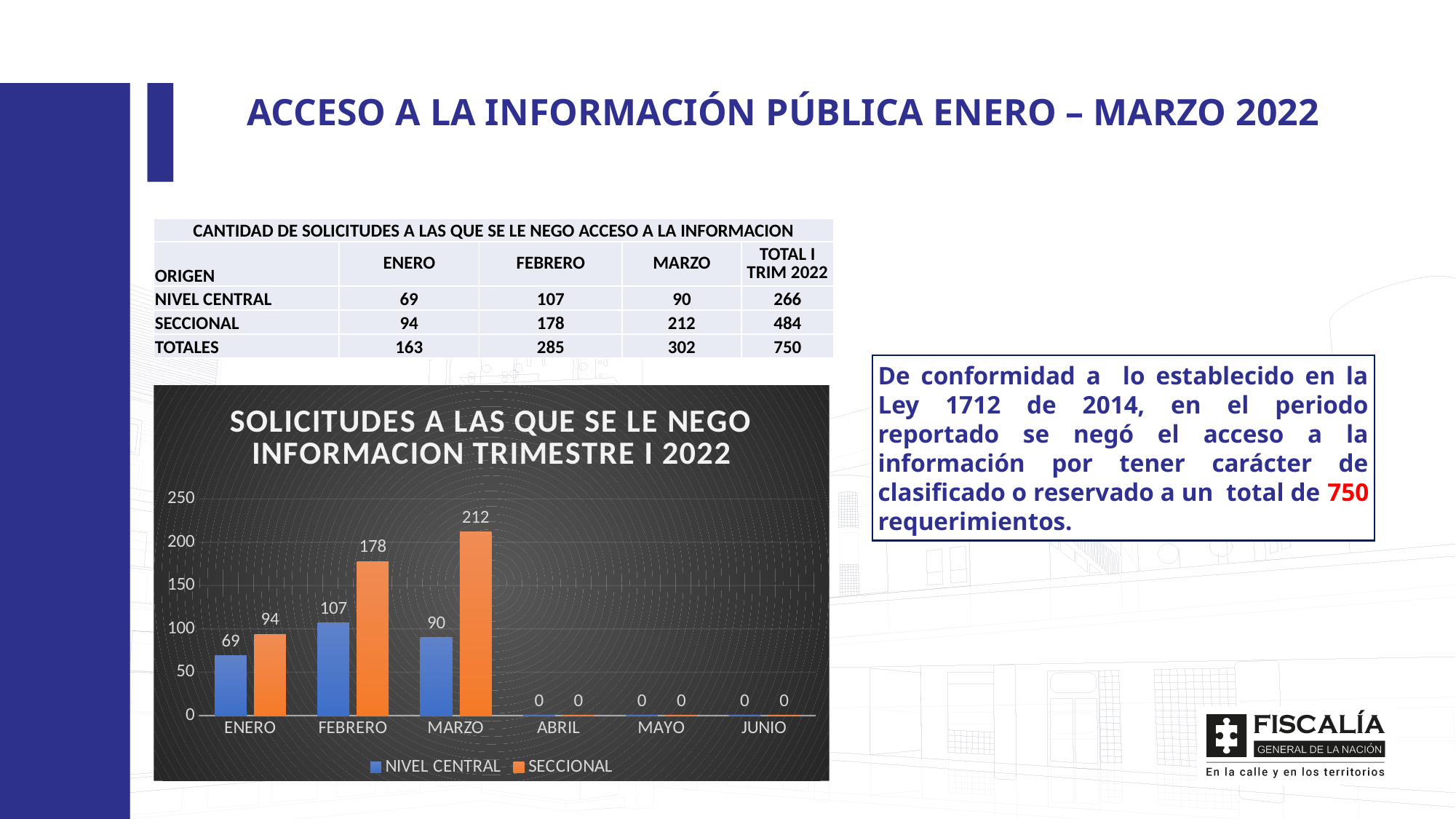
What is the value for NIVEL CENTRAL in FEBRERO? 107 What is the title of the chart? SOLICITUDES A LAS QUE SE LE NEGO INFORMACION TRIMESTRE I 2022 What is the difference between SECCIONAL and NIVEL CENTRAL in MARZO? 122 Which month has the highest value for SECCIONAL? MARZO Which is larger in FEBRERO, NIVEL CENTRAL or SECCIONAL? SECCIONAL How many series does the chart legend list? 2 What kind of chart is shown on the slide? Bar chart Which month has the highest value for NIVEL CENTRAL? FEBRERO What is the value for SECCIONAL in MARZO? 212 Does the SECCIONAL series rise or fall from ENERO to MARZO? Rise What is the value for NIVEL CENTRAL in ENERO? 69 How many months are shown on the x axis of the chart? 6